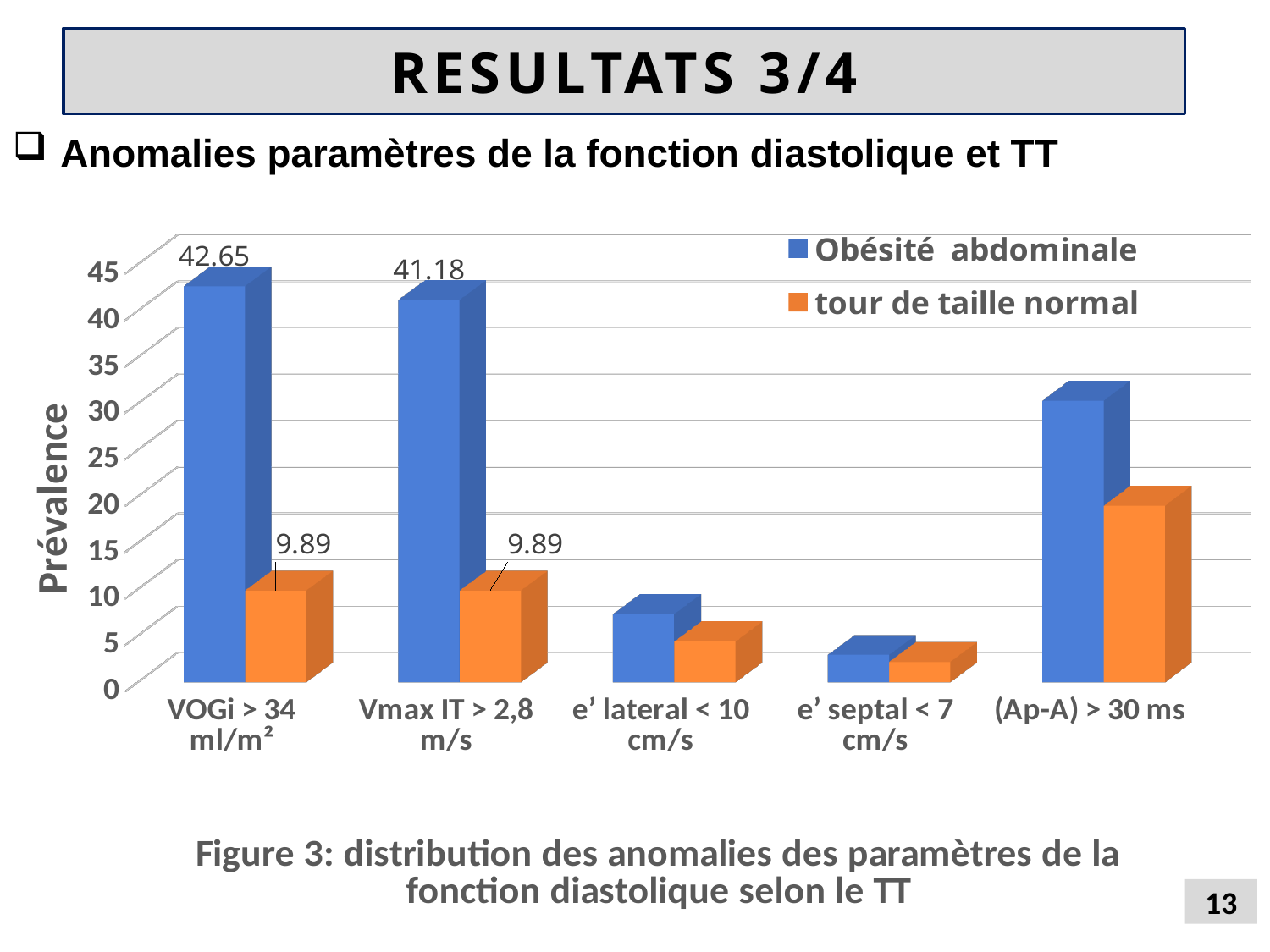
Is the Obésité abdominale value for (Ap-A) > 30 ms greater or less than 25? greater Which category has the lowest value for tour de taille normal? e’ septal < 7 cm/s What is the value for tour de taille normal in the Vmax IT > 2,8 m/s category? 9.89 How many categories are shown on the x axis? 5 What is the difference between the Obésité abdominale values for VOGi > 34 ml/m² and Vmax IT > 2,8 m/s? 1.47 What is the value for Obésité abdominale in the Vmax IT > 2,8 m/s category? 41.18 How many series does the legend list? 2 What is the difference between the Obésité abdominale and tour de taille normal values for VOGi > 34 ml/m²? 32.76 What is the value for Obésité abdominale in the VOGi > 34 ml/m² category? 42.65 Is the Obésité abdominale value for e’ lateral < 10 cm/s greater or less than 10? less Which category has the highest value for Obésité abdominale? VOGi > 34 ml/m² What kind of chart is shown on the slide? bar chart